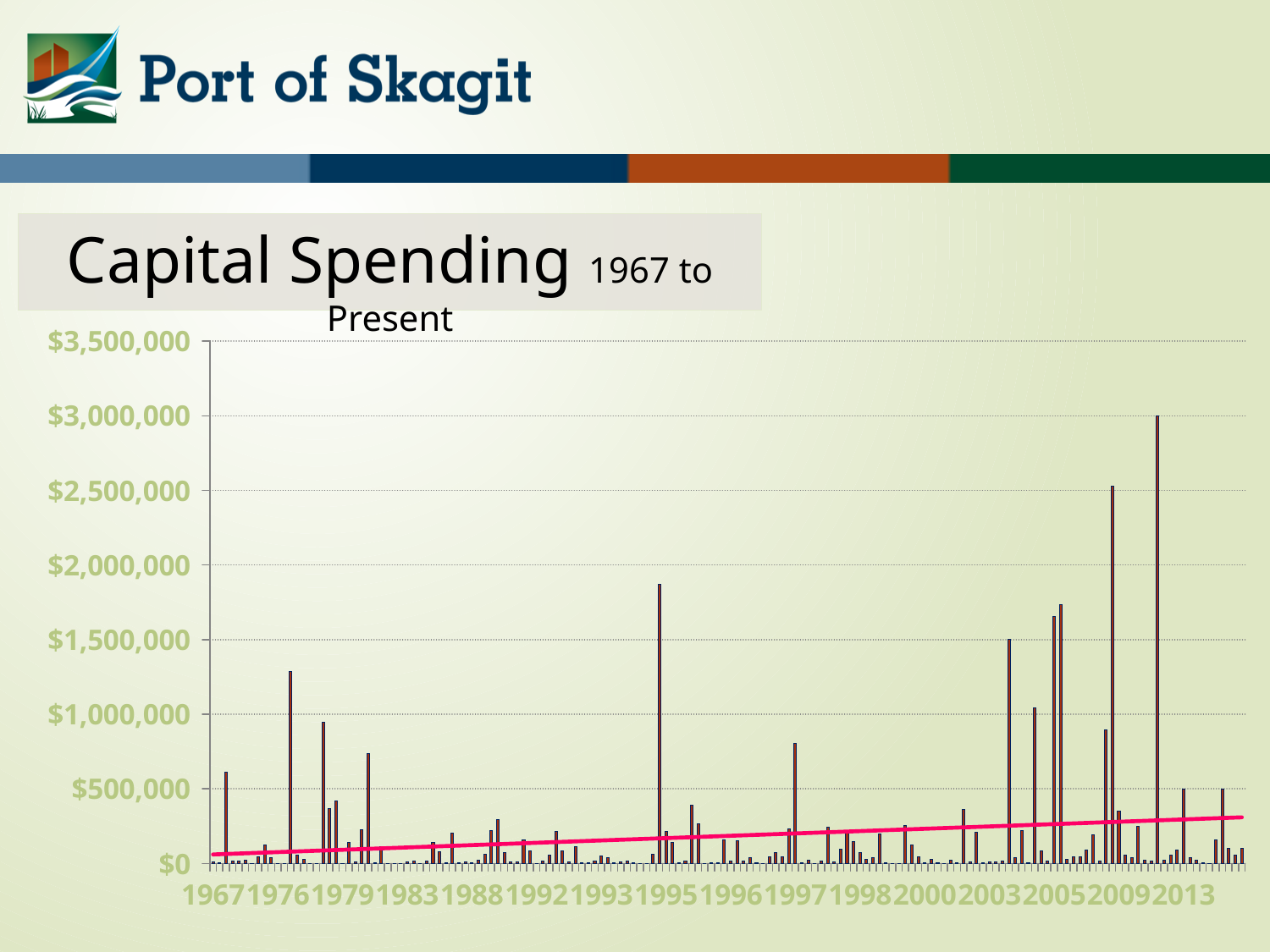
Which is taller: the tallest bar near the 2013 label or the tallest bar near the 1995 label? the bar near 2013 Is the value of the tallest bar on the chart greater or less than $2,500,000? greater Which is taller: the tallest bar near the 1976 label or the tallest bar near the 2009 label? the bar near 2009 What kind of chart is shown on the slide? bar chart What is the title of the chart? Capital Spending 1967 to Present Is the tallest bar near the 1976 label greater or less than $1,000,000? greater Is the value of the tallest bar on the chart greater or less than $3,500,000? less How many year labels are shown along the x axis? 16 Does the pink trend line rise or fall from left to right across the chart? rise What is the highest value labelled on the y axis? $3,500,000